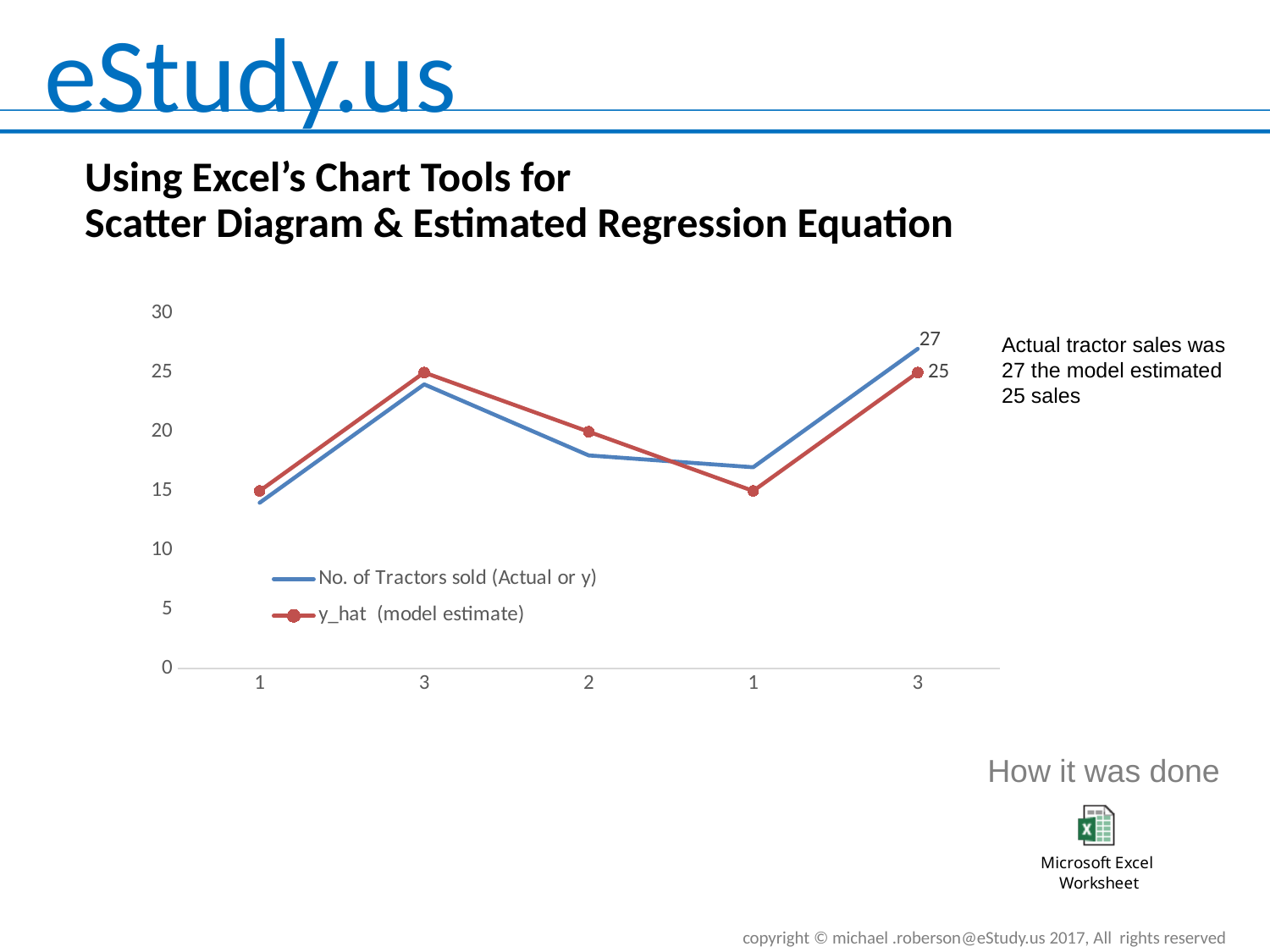
What kind of chart is shown on the slide? line chart What colour is the line for the 'y_hat (model estimate)' series? red What is the difference between the actual tractor sales and the model estimate at the last point? 2 Is the value of the 'No. of Tractors sold (Actual or y)' series at the second point greater or less than 20? greater Is the value of the 'y_hat (model estimate)' series at the fourth point greater or less than 20? less How many series does the chart's legend list? 2 At the last point, which is larger: the actual number of tractors sold or the model estimate? the actual number of tractors sold What is the highest labelled value for the 'No. of Tractors sold (Actual or y)' series? 27 What is the data label on the last point of the 'No. of Tractors sold (Actual or y)' series? 27 Between the fourth and fifth points, does the 'y_hat (model estimate)' series rise or fall? rise What is the data label on the last point of the 'y_hat (model estimate)' series? 25 How many data points does each series have along the x axis? 5